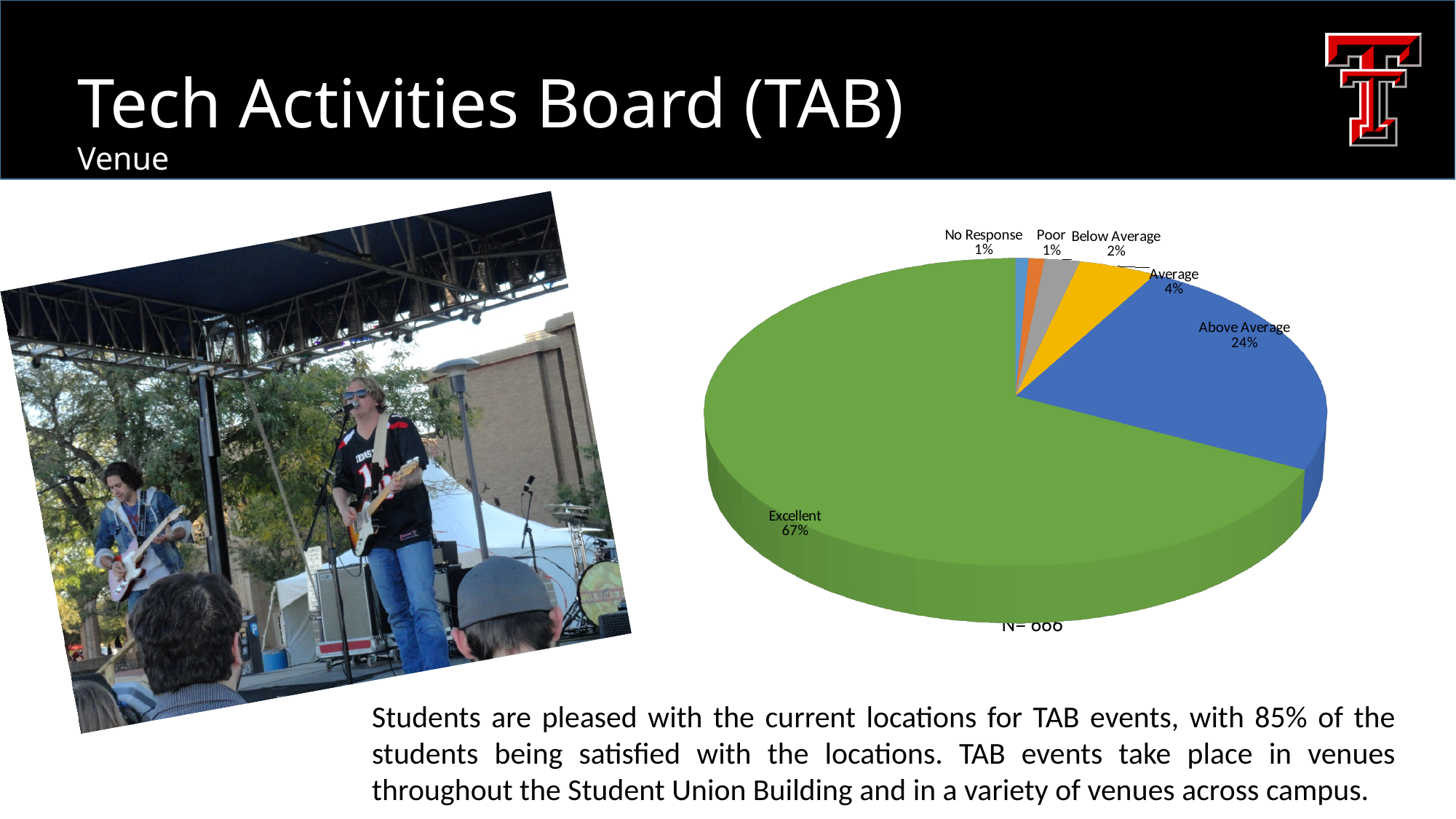
What share of the pie does Excellent represent? 67% What share of the pie does Below Average represent? 2% What share of the pie does Average represent? 4% What is the difference in percentage points between Excellent and Above Average? 43 Which category has the largest slice of the pie? Excellent What share of the pie does Above Average represent? 24% What share of the pie does No Response represent? 1% How many slices does the pie chart have? 6 Which is larger, the Average slice or the Below Average slice? Average What share of the pie does Poor represent? 1% What kind of chart is shown on the slide? pie chart What colour is the Excellent slice of the pie? green